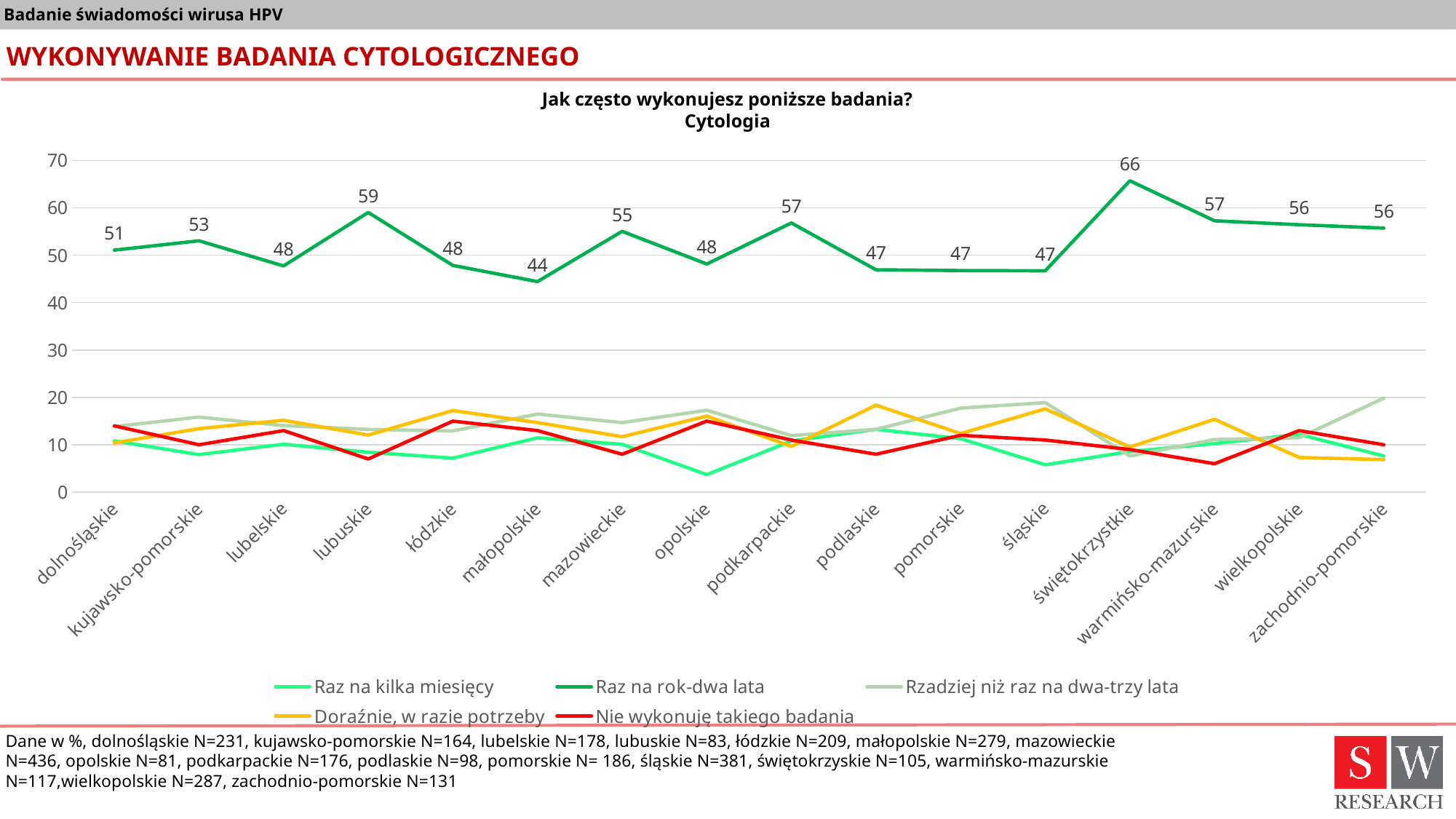
What is the difference between the "Raz na rok-dwa lata" values for świętokrzyskie and małopolskie? 22 What is the value for "Raz na rok-dwa lata" in świętokrzyskie? 66 For "Raz na rok-dwa lata", which is larger: mazowieckie or opolskie? mazowieckie Is the value for "Nie wykonuję takiego badania" in lubuskie greater or less than 10? less Is the value for "Raz na kilka miesięcy" in opolskie greater or less than 10? less Which region has the highest value for "Raz na rok-dwa lata"? świętokrzyskie What kind of chart is shown on the slide? line chart Which region has the lowest value for "Raz na rok-dwa lata"? małopolskie How many series does the legend list? 5 What is the value for "Raz na rok-dwa lata" in małopolskie? 44 How many regions are shown on the x axis? 16 What is the value for "Raz na rok-dwa lata" in lubuskie? 59